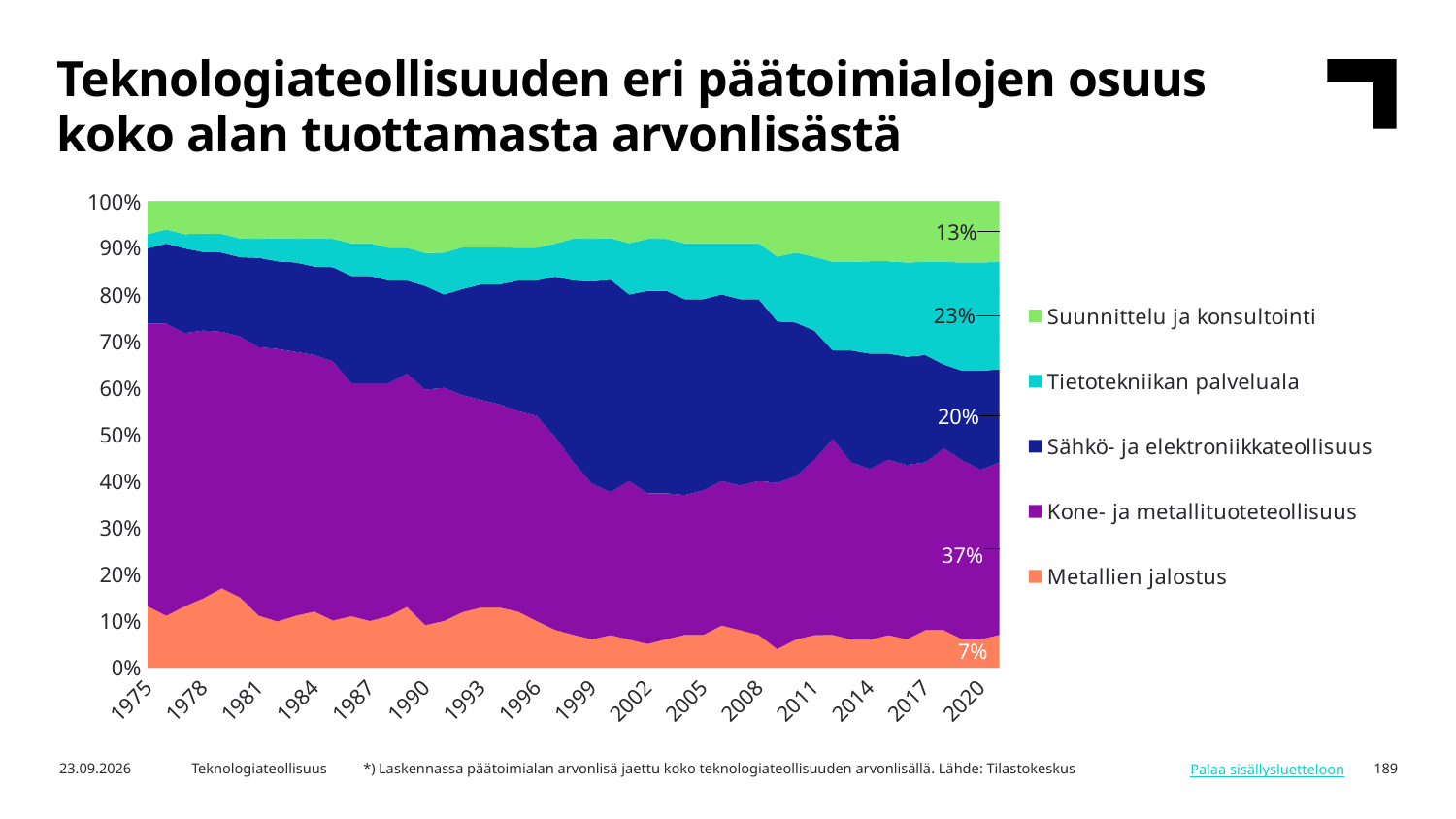
How many series does the legend list? 5 Which sector has the largest share in 2020? Kone- ja metallituoteteollisuus What is the difference in percentage points between the 2020 shares of Kone- ja metallituoteteollisuus and Metallien jalostus? 30 percentage points Which sector has the smallest share in 2020? Metallien jalostus Which colour represents Metallien jalostus in the chart? Orange What kind of chart is shown on the slide? Area chart In 2020, which is larger: the share of Tietotekniikan palveluala or Sähkö- ja elektroniikkateollisuus? Tietotekniikan palveluala Does the share of Kone- ja metallituoteteollisuus rise or fall from 1975 to 2020? Fall What is the share of Suunnittelu ja konsultointi in 2020? 13% What is the share of Tietotekniikan palveluala in 2020? 23%